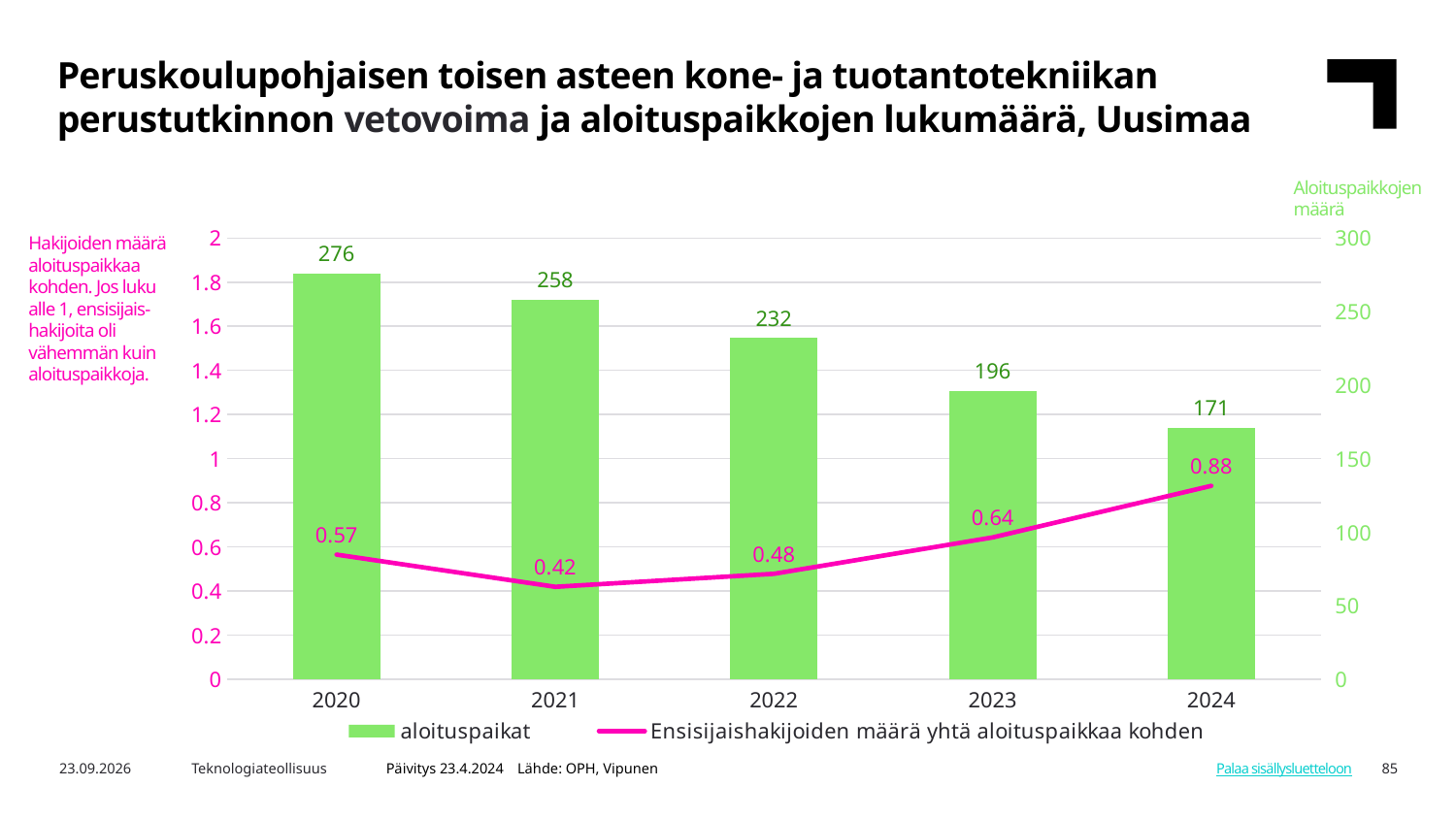
What is the value of Ensisijaishakijoiden määrä yhtä aloituspaikkaa kohden in 2021? 0.42 Is the value for Ensisijaishakijoiden määrä yhtä aloituspaikkaa kohden in 2023 greater or less than 1? less Which year has the lowest value for aloituspaikat? 2024 How many years are shown on the x axis? 5 What is the value of aloituspaikat in 2020? 276 What colour are the aloituspaikat bars? green Which year has the highest value for Ensisijaishakijoiden määrä yhtä aloituspaikkaa kohden? 2024 How many series does the legend list? 2 Do the aloituspaikat values rise or fall from 2020 to 2024? fall What is the difference between aloituspaikat in 2020 and 2024? 105 What is the value of aloituspaikat in 2024? 171 Which is larger, the aloituspaikat value in 2022 or in 2023? 2022